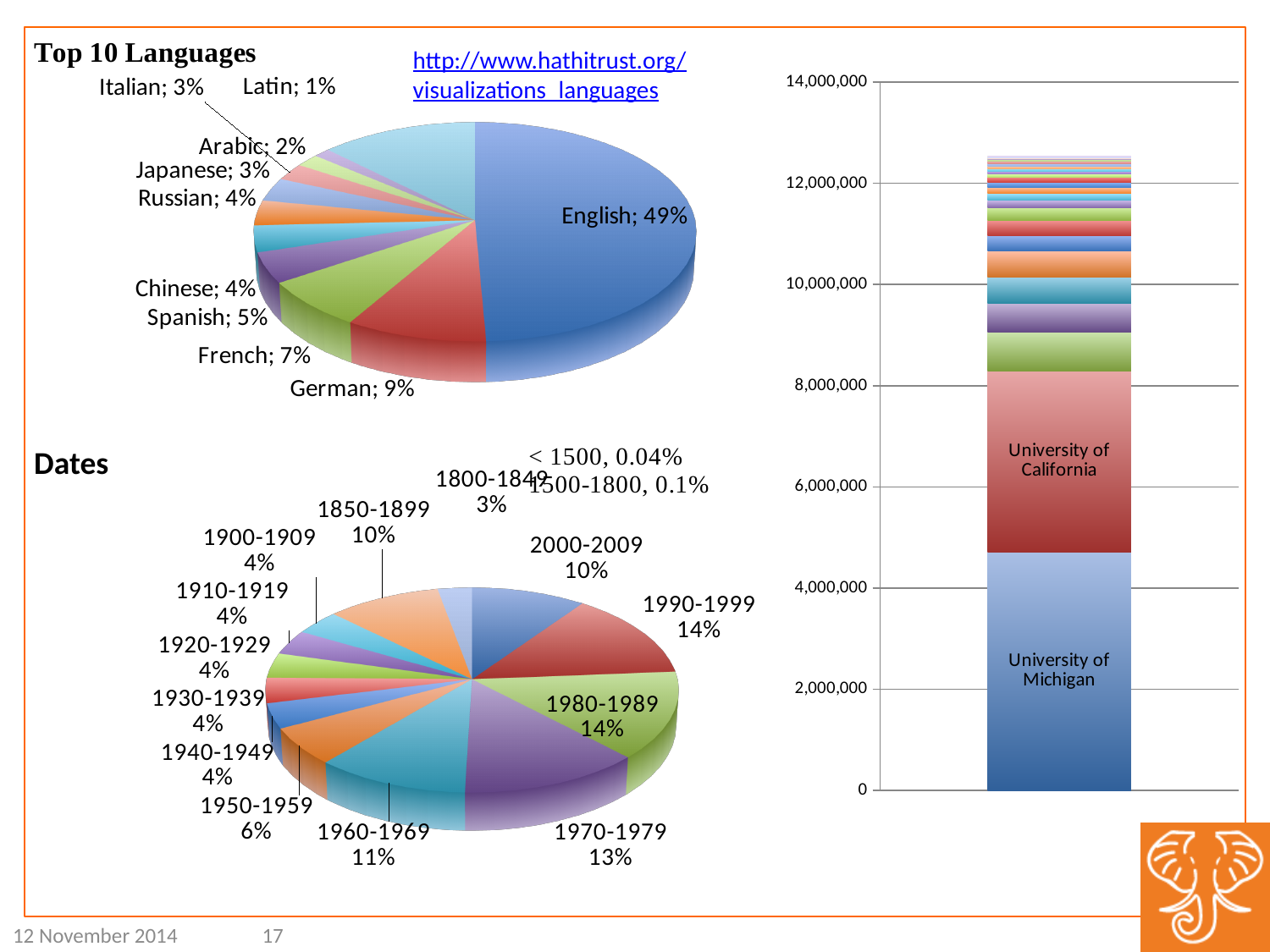
In the Dates pie chart, which date range has the smallest share? < 1500 In the Top 10 Languages pie chart, which has the larger share, Spanish or Chinese? Spanish In the stacked bar chart on the right, is the value for University of Michigan greater or less than 4,000,000? greater What kind of chart is the Dates chart? pie chart What kind of chart is the chart on the right side of the slide? bar chart In the Top 10 Languages pie chart, what is the difference between the German and French percentages? 2% In the Top 10 Languages pie chart, which language has the largest share? English How many date ranges are shown in the Dates pie chart? 15 In the Dates pie chart, what percentage is shown for 1970-1979? 13% In the Top 10 Languages pie chart, what percentage is shown for English? 49% In the Dates pie chart, what is the difference between the 1960-1969 and 1950-1959 percentages? 5% In the Top 10 Languages pie chart, which language has the smallest share? Latin